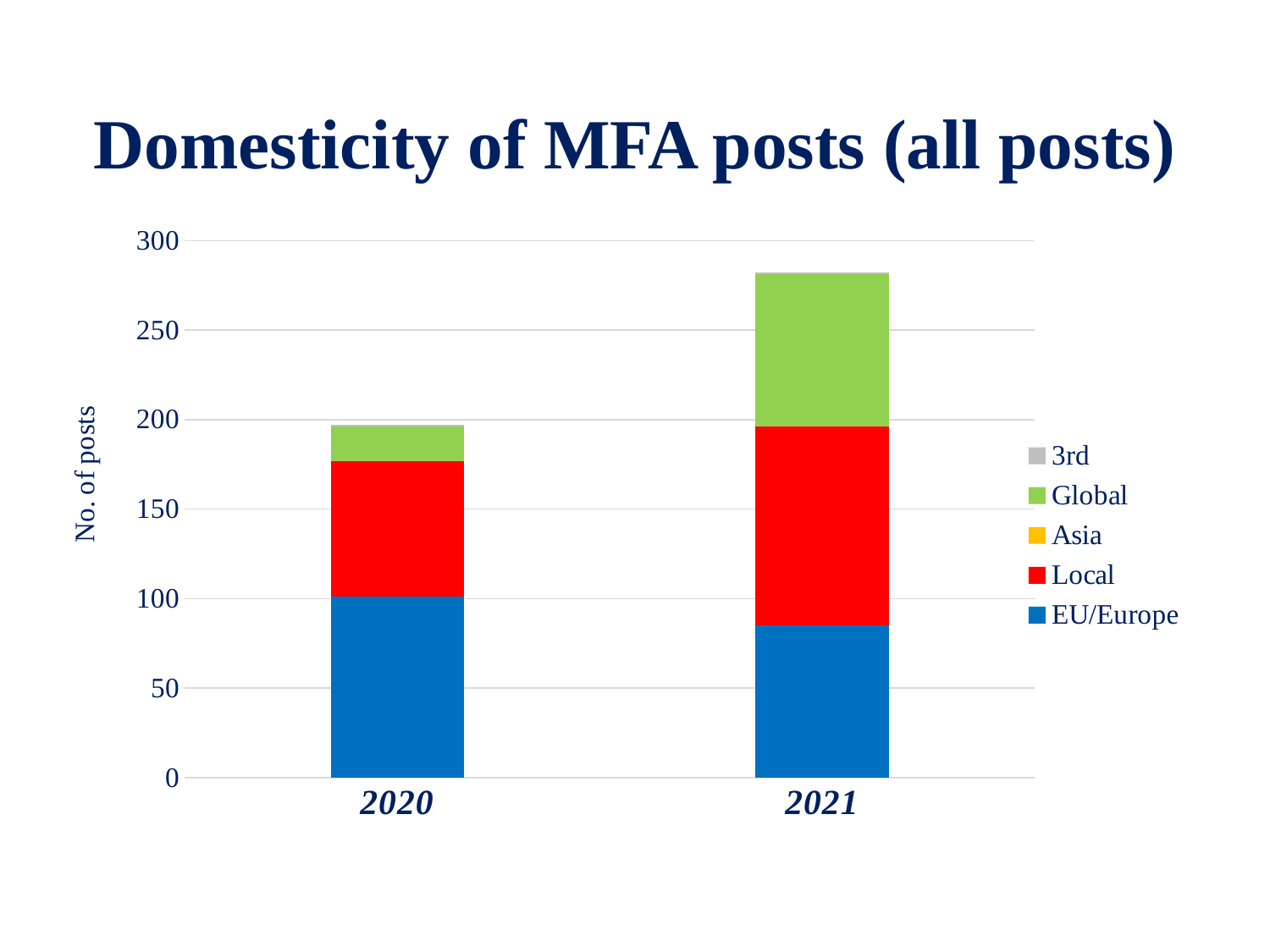
Is the total height of the 2021 bar greater or less than 250? greater Which year has the larger Global segment, 2020 or 2021? 2021 Is the total height of the 2020 bar greater or less than 150? greater What is the label on the vertical axis? No. of posts Is the EU/Europe value for 2021 greater or less than 100? less Which year has the taller total bar, 2020 or 2021? 2021 What kind of chart is shown on the slide? Stacked bar chart Which year has the larger EU/Europe segment, 2020 or 2021? 2020 How many series does the legend list? 5 How many years (categories) are shown on the x axis? 2 Does the total number of posts rise or fall from 2020 to 2021? rise